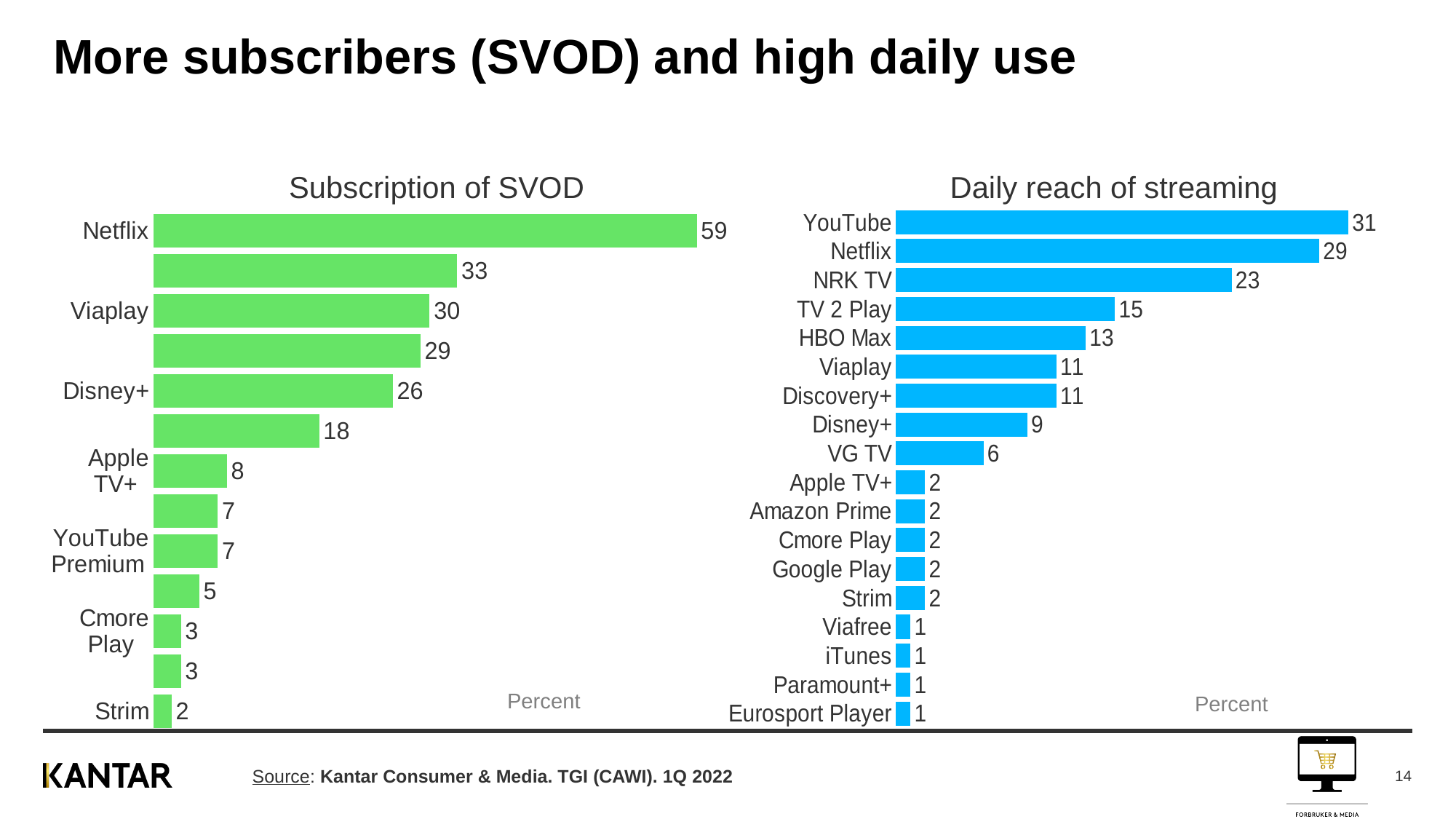
In the 'Daily reach of streaming' chart, what is the difference between the values for YouTube and Netflix? 2 In the 'Subscription of SVOD' chart, what is the difference between the values for Netflix and Viaplay? 29 In the 'Daily reach of streaming' chart, which category has the highest value? YouTube In the 'Subscription of SVOD' chart, what is the value for Disney+? 26 In the 'Daily reach of streaming' chart, which is larger, the value for TV 2 Play or the value for Disney+? TV 2 Play In the 'Subscription of SVOD' chart, what is the value for Netflix? 59 How many categories are shown in the 'Daily reach of streaming' chart? 18 In the 'Subscription of SVOD' chart, which category has the lowest value? Strim In the 'Daily reach of streaming' chart, what is the value for NRK TV? 23 In the 'Daily reach of streaming' chart, what is the value for HBO Max? 13 In the 'Subscription of SVOD' chart, which category has the highest value? Netflix What type of chart is the 'Subscription of SVOD' chart? Bar chart